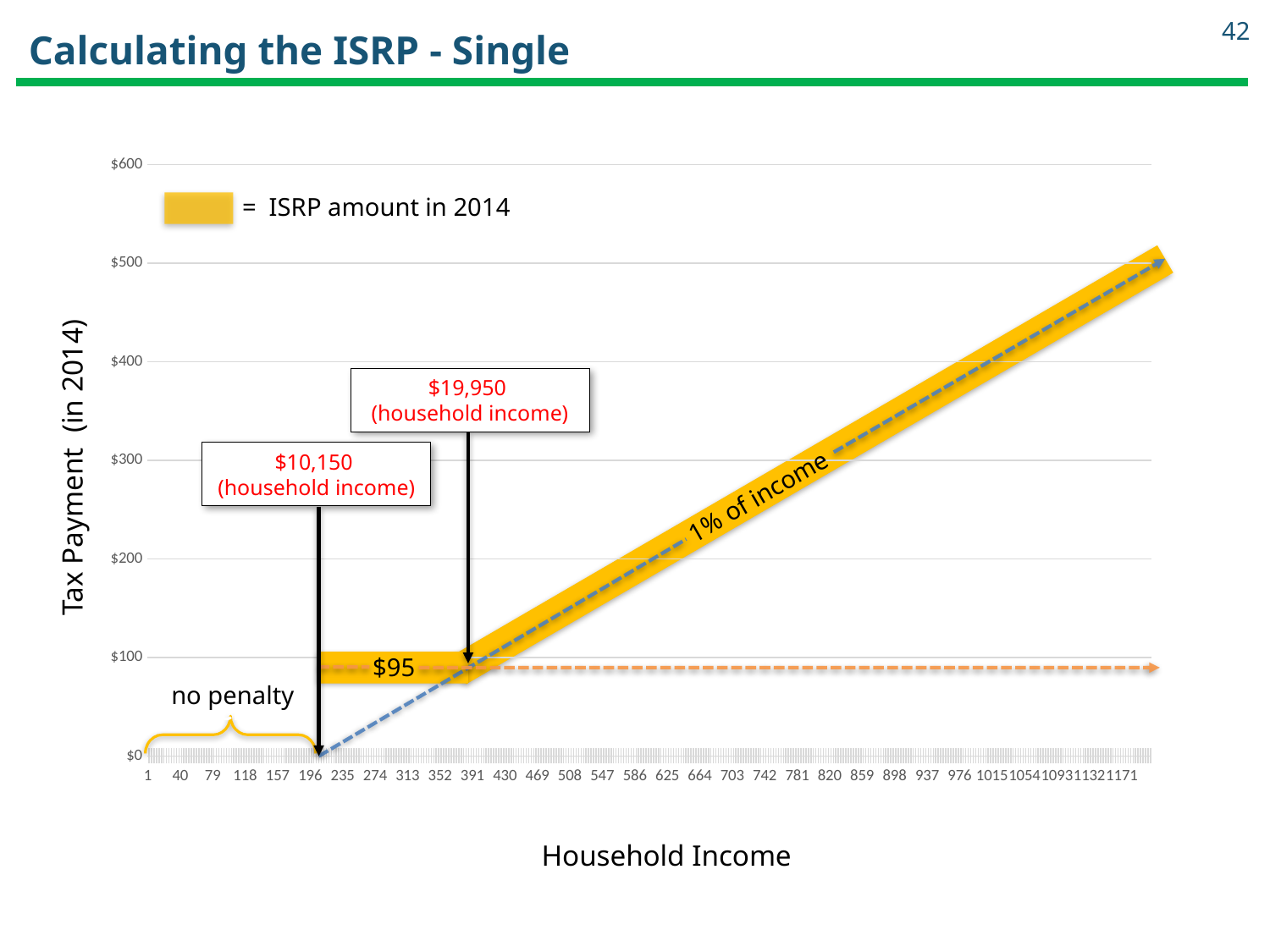
What kind of chart is shown on the slide? line chart Does the ISRP amount rise or fall as household income increases beyond $19,950? rises What is the title of the y-axis on the chart? Tax Payment (in 2014) What flat ISRP amount is labeled on the chart for household incomes between $10,150 and $19,950? $95 What label describes the sloped portion of the ISRP band on the chart? 1% of income What label describes the region of household income below $10,150 on the chart? no penalty Is the flat ISRP amount shown on the chart greater or less than $100? less At what household income does the chart indicate the ISRP switches from the flat amount to 1% of income? $19,950 What is the highest value shown on the y-axis of the chart? $600 At what household income does the chart indicate the ISRP penalty begins? $10,150 What does the yellow band in the chart represent, according to the legend? ISRP amount in 2014